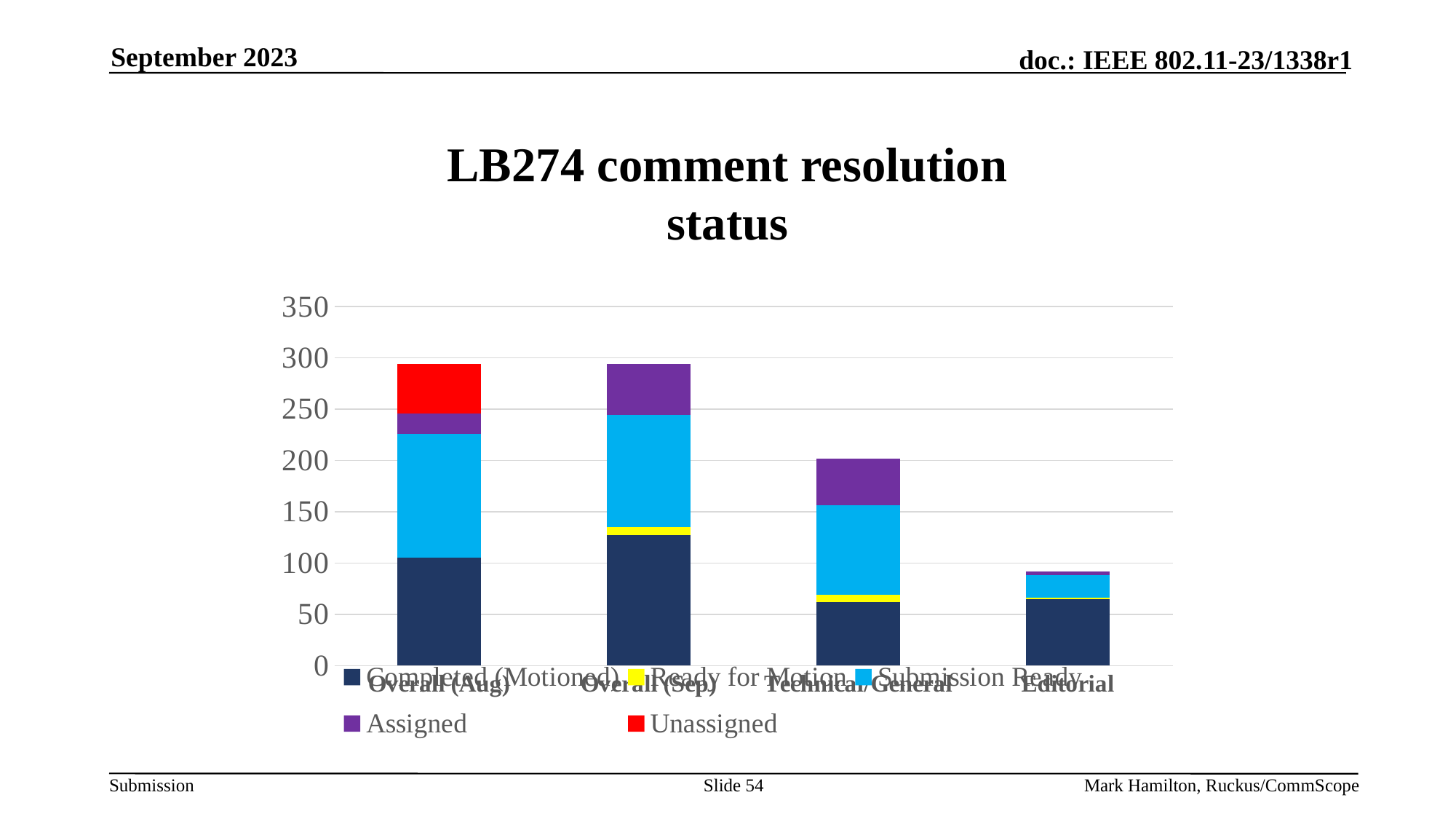
Is the total for Overall (Aug) greater or less than 250? greater Is the total for Editorial greater or less than 100? less Which has the larger Assigned segment, Overall (Aug) or Overall (Sep)? Overall (Sep) Which category is the only one with an Unassigned (red) segment? Overall (Aug) Which has the larger total, Technical/General or Editorial? Technical/General What kind of chart is shown on the slide? stacked bar chart What is the title of the chart? LB274 comment resolution status Which category has the lowest total bar height? Editorial How many categories are shown on the x axis of the chart? 4 Is the total for Technical/General greater or less than 150? greater How many series does the legend list? 5